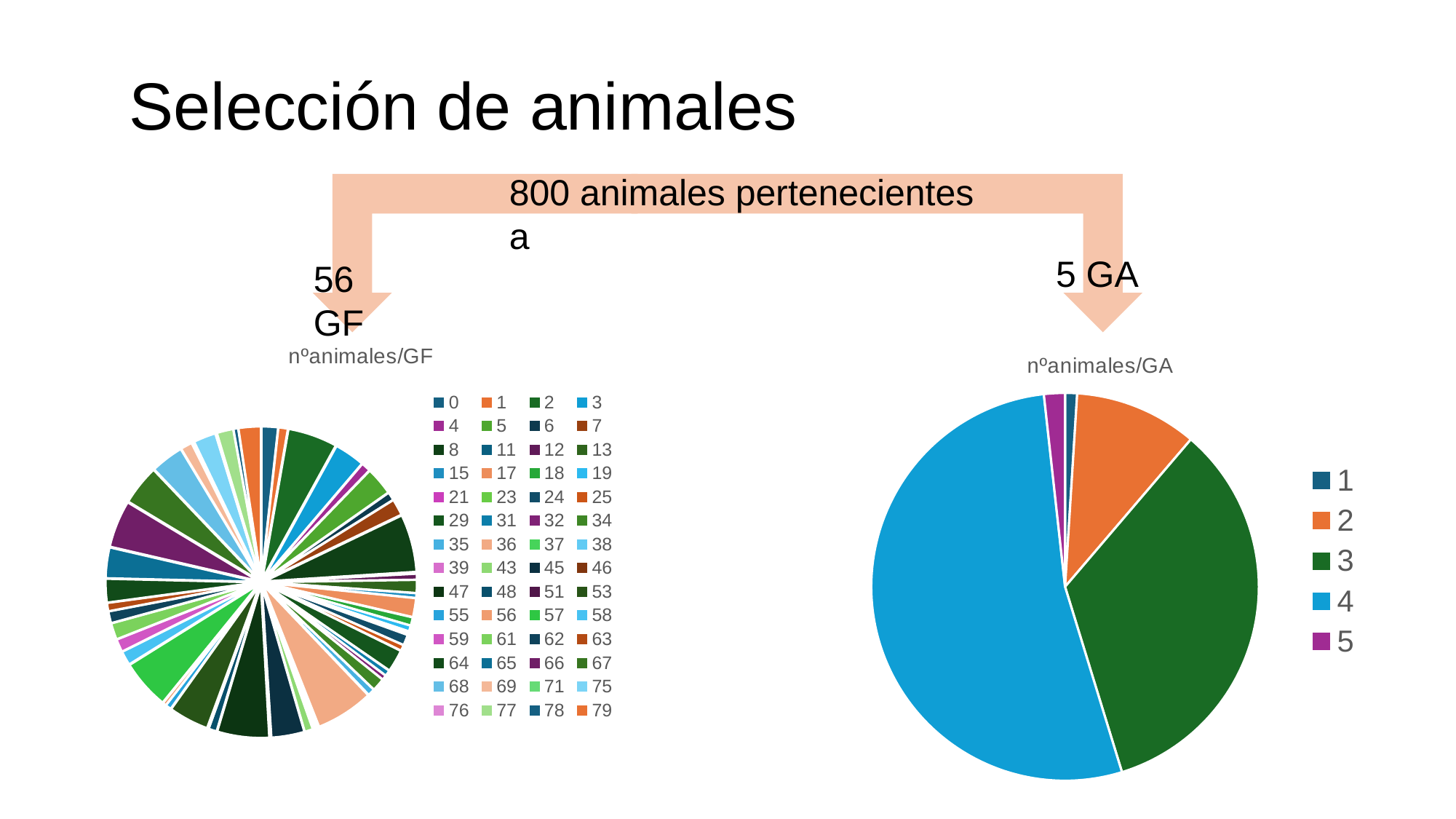
In the chart titled "nºanimales/GA", what colour is the slice for category 4? blue In the chart titled "nºanimales/GA", which category has the largest slice? 4 What kind of chart is the chart titled "nºanimales/GA"? pie chart In the chart titled "nºanimales/GF", how many categories does the legend list? 56 What is the title of the pie chart on the right side of the slide? nºanimales/GA In the chart titled "nºanimales/GA", which slice is larger, category 2 or category 5? 2 In the chart titled "nºanimales/GA", how many categories does the legend list? 5 In the chart titled "nºanimales/GA", which slice is larger, category 3 or category 2? 3 In the chart titled "nºanimales/GA", which slice is larger, category 4 or category 3? 4 What kind of chart is the chart titled "nºanimales/GF"? pie chart